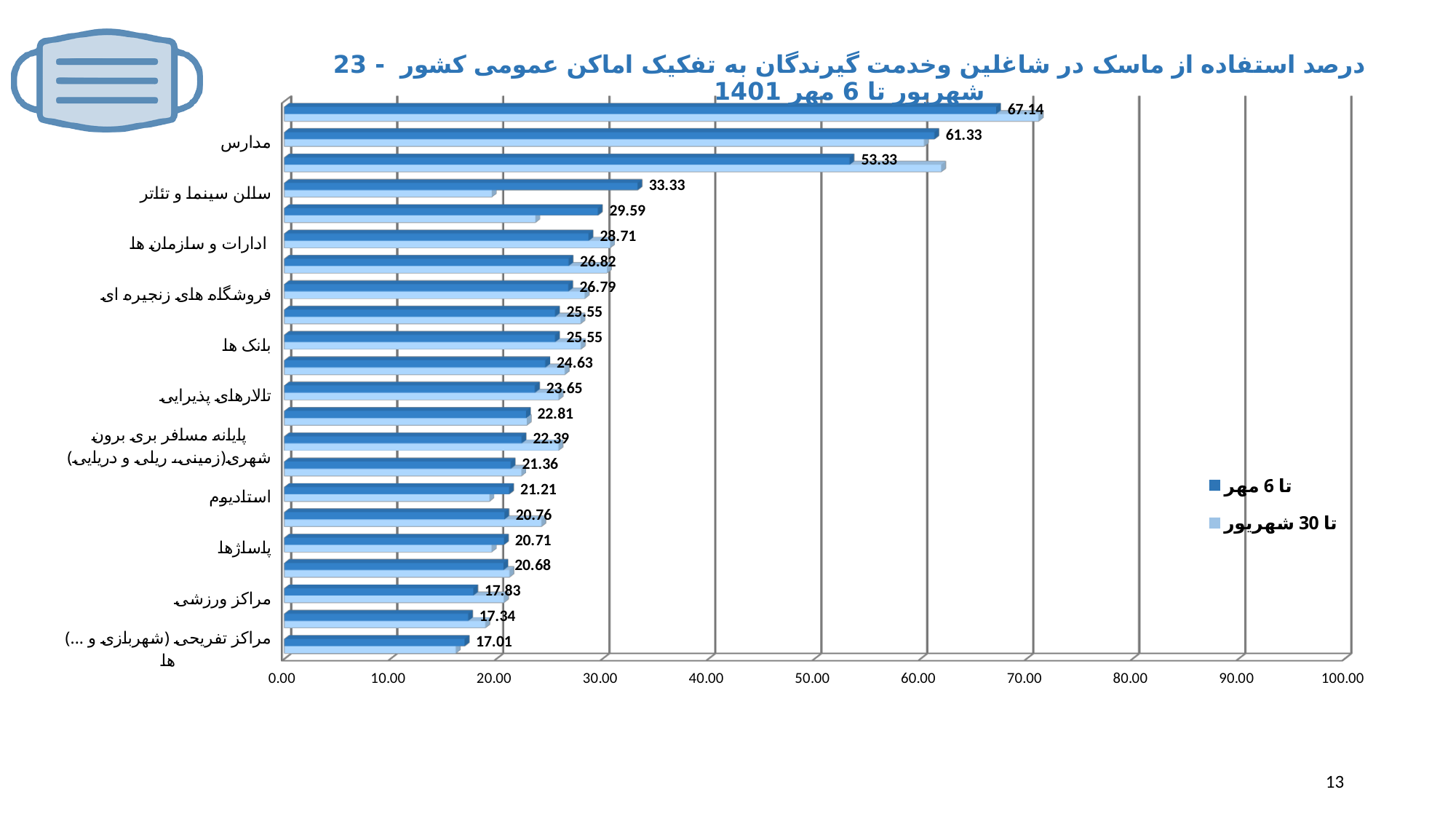
What is the highest data label shown on the chart? 67.14 Which has the larger تا 6 مهر value, مراکز ورزشی or مراکز تفریحی (شهربازی و ...) ها? مراکز ورزشی What are the two series named in the legend? تا 6 مهر and تا 30 شهریور What is the value labelled for مراکز تفریحی (شهربازی و ...) ها in the تا 6 مهر series? 17.01 Is the تا 30 شهریور value for the topmost category greater or less than 70.00? greater What is the lowest data label shown on the chart? 17.01 What kind of chart is shown on the slide? bar chart What is the difference between the two highest data labels, 67.14 and 61.33? 5.81 How many series does the legend list? 2 What is the maximum value shown on the horizontal axis? 100.00 What is the value labelled for مراکز ورزشی in the تا 6 مهر series? 17.83 How many bars are plotted for the تا 6 مهر series? 22